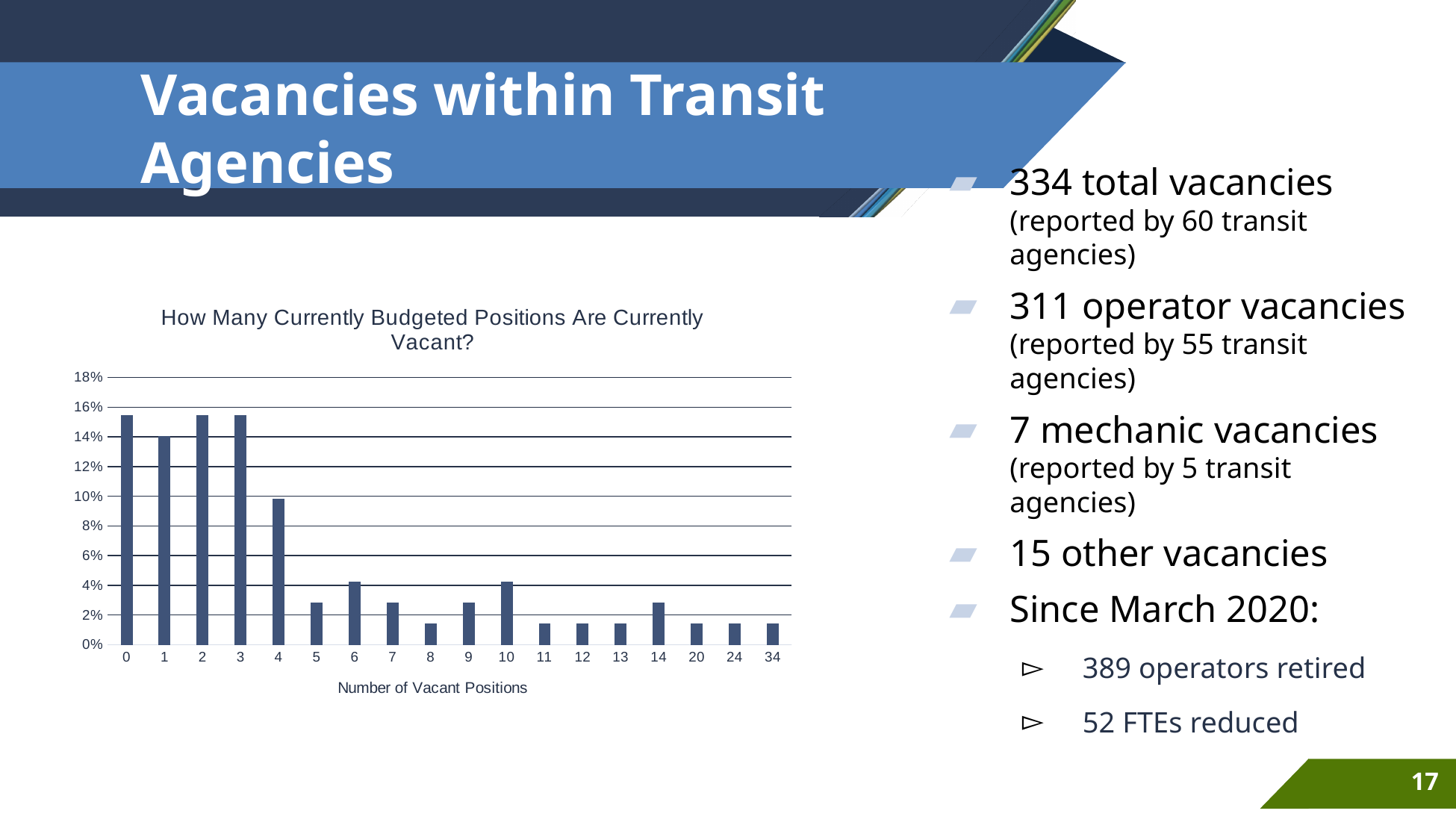
Is the value for 5 vacant positions greater or less than 4%? less How many categories (numbers of vacant positions) are shown on the x axis? 18 Is the value for 4 vacant positions greater or less than 8%? greater What is the label on the x axis of the chart? Number of Vacant Positions What is the title of the chart? How Many Currently Budgeted Positions Are Currently Vacant? Which has a larger value, 4 vacant positions or 5 vacant positions? 4 vacant positions Is the value for 34 vacant positions greater or less than 2%? less Do the values generally rise or fall as the number of vacant positions increases along the x axis? fall What kind of chart is shown on the slide? bar chart Which has a larger value, 6 vacant positions or 8 vacant positions? 6 vacant positions